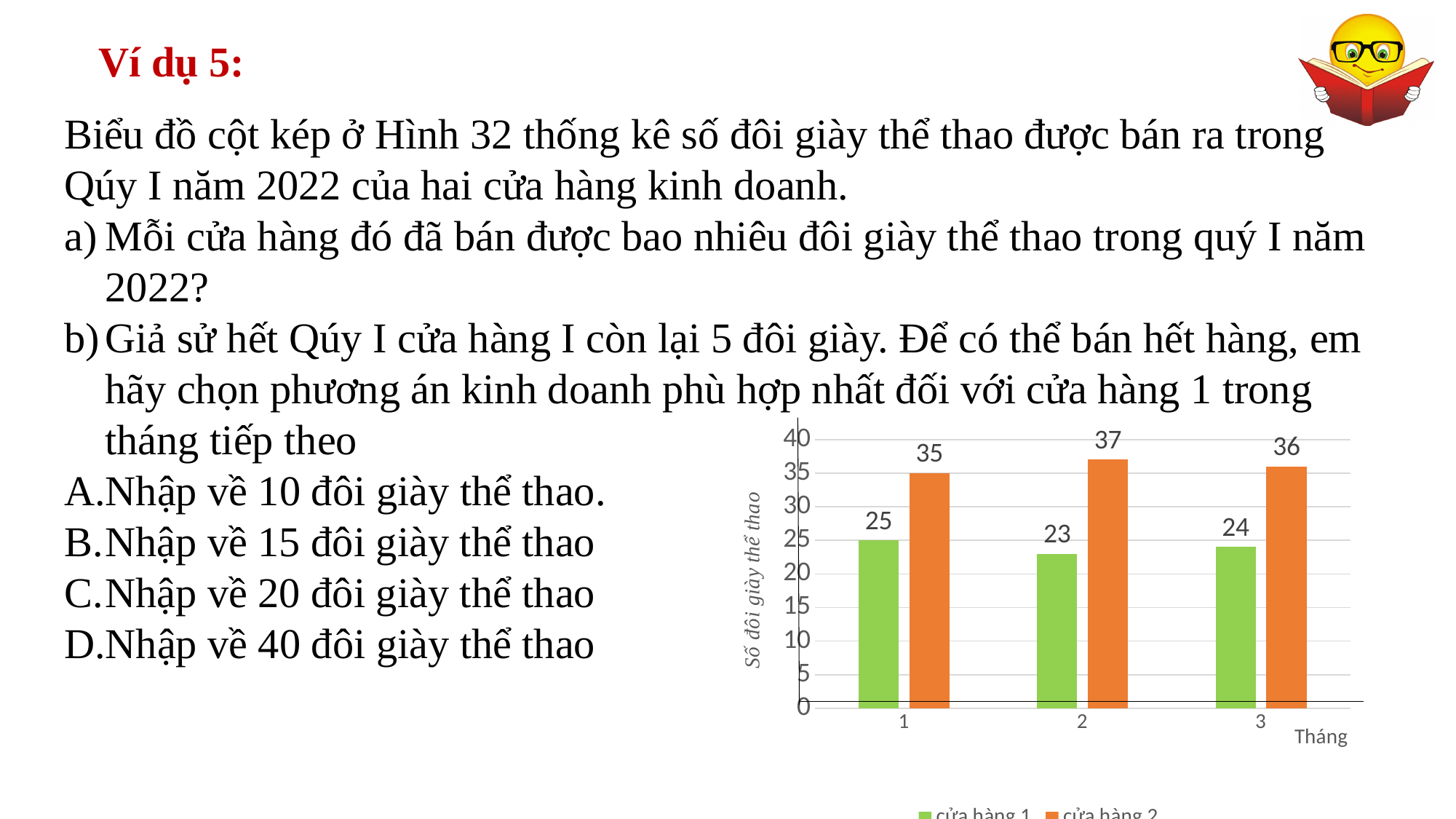
In which month does cửa hàng 2 have its highest value? 2 What is the value for cửa hàng 2 in month 2? 37 How many series does the legend list? 2 Which is larger in month 3: cửa hàng 1 or cửa hàng 2? cửa hàng 2 What is the difference between cửa hàng 2 and cửa hàng 1 in month 1? 10 What is the label of the vertical axis? Số đôi giày thể thao What kind of chart is shown on the slide? bar chart In which month does cửa hàng 1 have its lowest value? 2 Is the value for cửa hàng 2 in month 3 greater or less than 30? greater What is the value for cửa hàng 1 in month 3? 24 What is the value for cửa hàng 1 in month 1? 25 How many months are shown on the x axis? 3